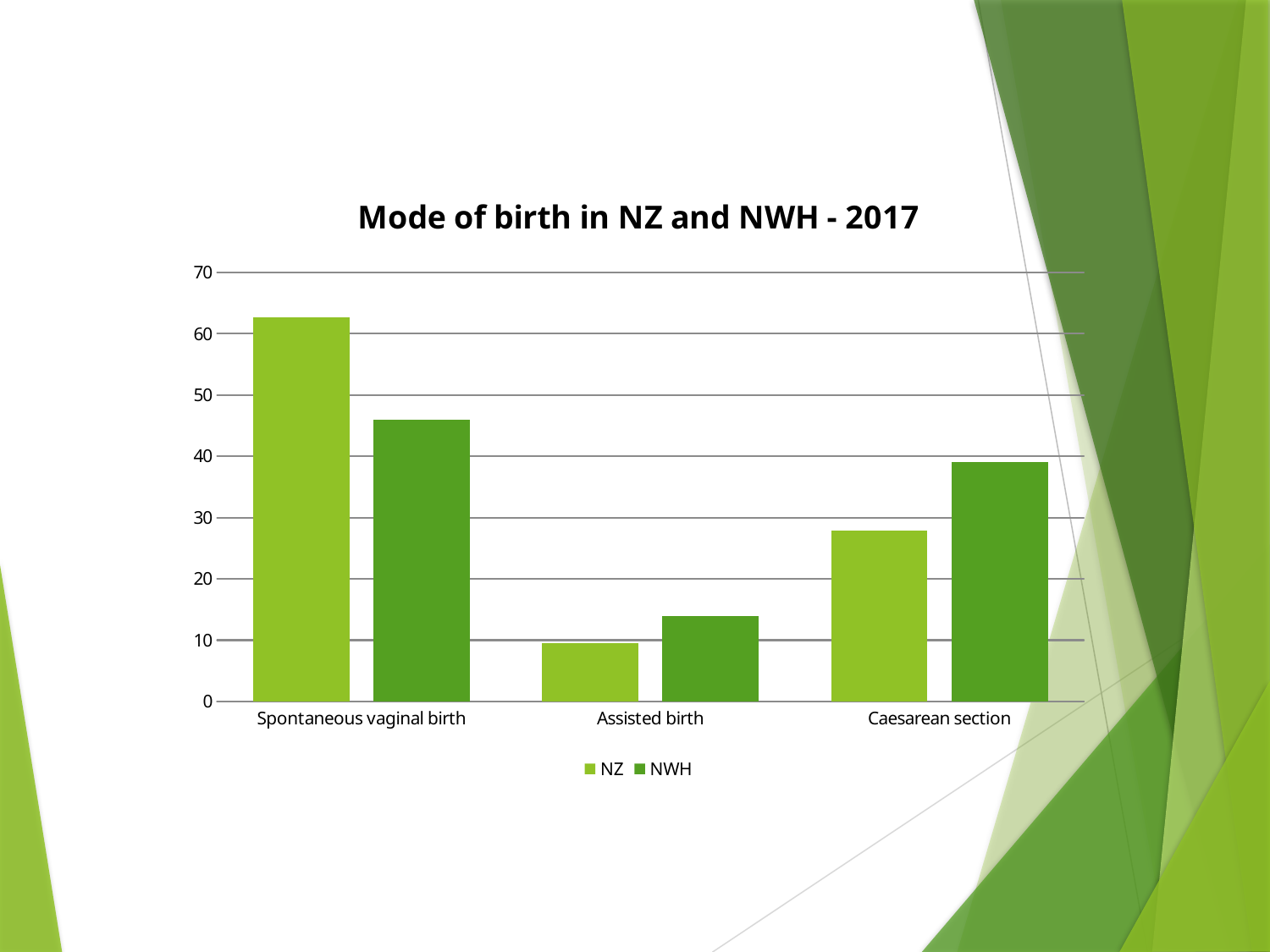
For Spontaneous vaginal birth, which series has the larger value, NZ or NWH? NZ For Caesarean section, which series has the larger value, NZ or NWH? NWH How many categories are shown on the x axis? 3 What kind of chart is shown on the slide? bar chart How many series does the legend list? 2 Is the NZ value for Spontaneous vaginal birth greater or less than 60? greater What is the title of the chart? Mode of birth in NZ and NWH - 2017 Which category has the lowest NWH value? Assisted birth Is the NWH value for Caesarean section greater or less than 30? greater Which category has the highest NZ value? Spontaneous vaginal birth Which series is shown in the darker green colour? NWH